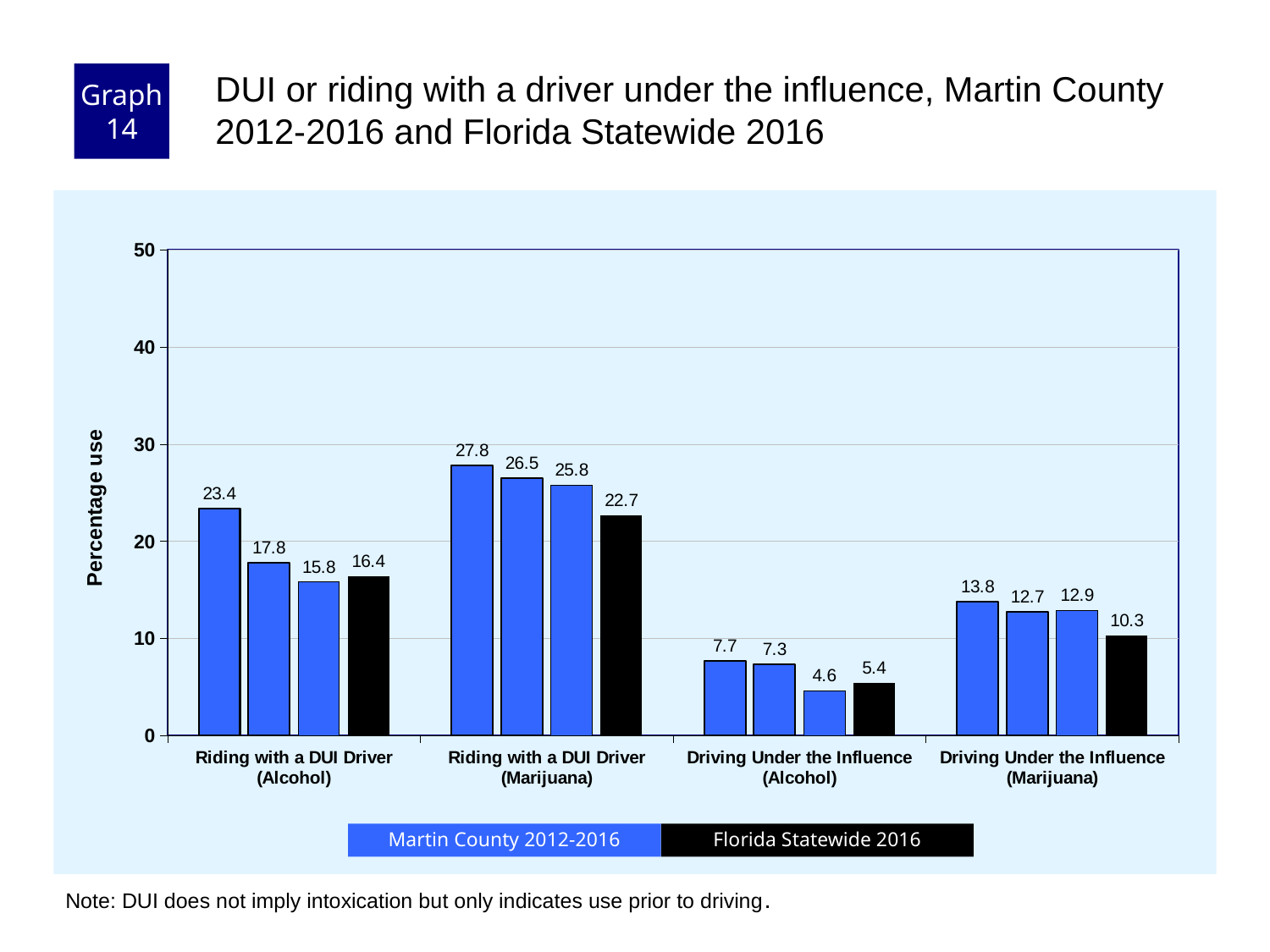
What is the Florida Statewide 2016 value for Riding with a DUI Driver (Marijuana)? 22.7 What is the value of the first (leftmost) Martin County bar for Riding with a DUI Driver (Alcohol)? 23.4 How many series does the legend list? 2 Which category has the lowest bar on the chart? Driving Under the Influence (Alcohol) Is the Florida Statewide 2016 value for Riding with a DUI Driver (Alcohol) greater or less than 20? less What kind of chart is shown on the slide? bar chart Which category has the highest bar on the chart? Riding with a DUI Driver (Marijuana) What is the Florida Statewide 2016 value for Driving Under the Influence (Alcohol)? 5.4 What is the difference between the first Martin County bar (27.8) and the Florida Statewide 2016 bar (22.7) for Riding with a DUI Driver (Marijuana)? 5.1 How many categories are shown on the x axis? 4 What is the value of the third Martin County bar for Driving Under the Influence (Marijuana)? 12.9 For Driving Under the Influence (Marijuana), which is larger: the Florida Statewide 2016 value or the third Martin County bar? the third Martin County bar (12.9)